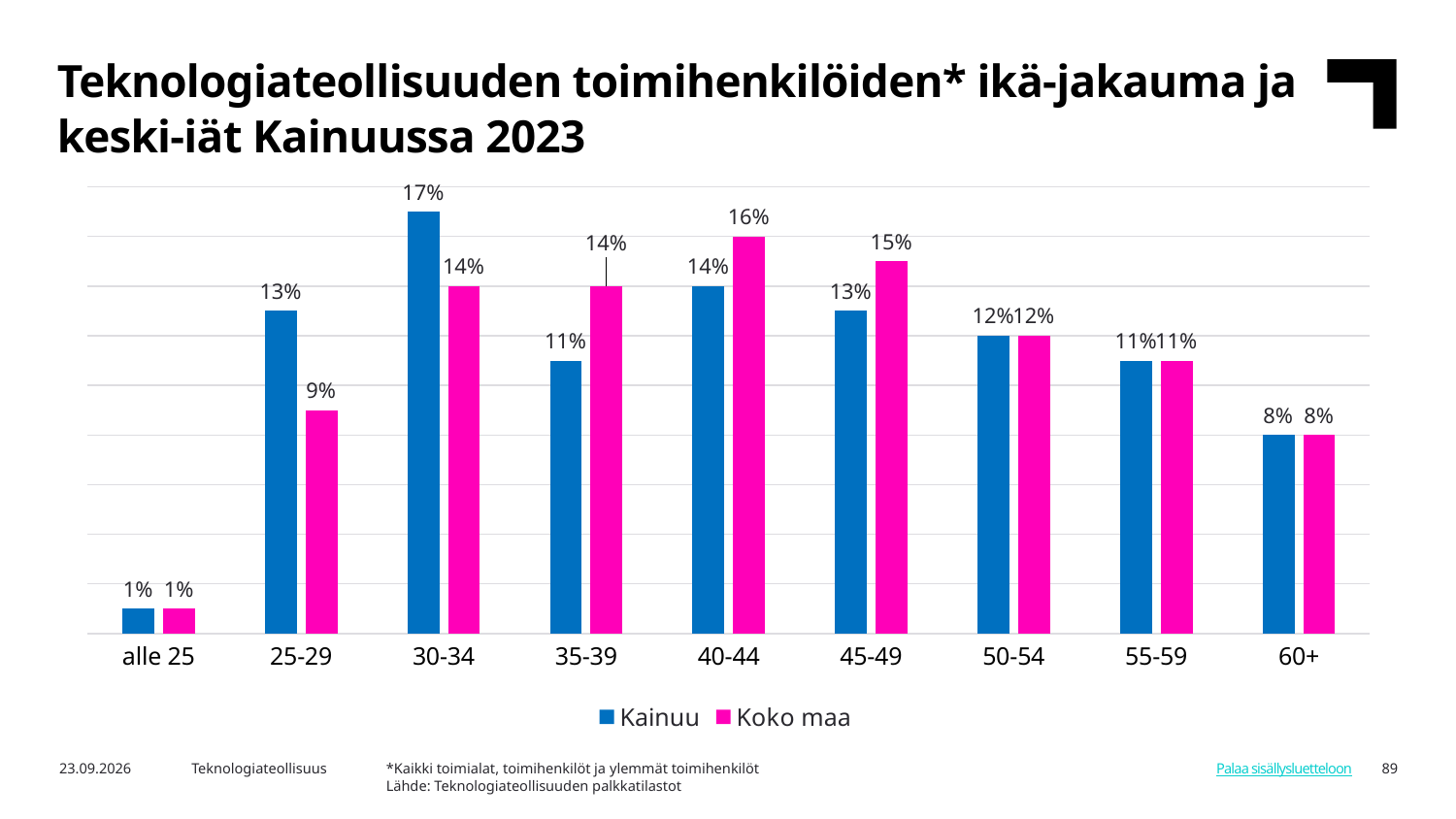
What is the Koko maa value for the 40-44 age group? 16% What is the Koko maa value for the 25-29 age group? 9% How many series does the legend list? 2 What is the Kainuu value for the 30-34 age group? 17% For the 35-39 age group, which is larger: the Kainuu value or the Koko maa value? Koko maa Which age group has the lowest Koko maa value? alle 25 Which series is shown in pink in the legend? Koko maa Do the Kainuu values rise or fall from the 45-49 age group to the 60+ age group? Fall What kind of chart is shown on the slide? Bar chart How many age groups are shown on the x axis? 9 Which age group has the highest Kainuu value? 30-34 What is the difference between the Kainuu and Koko maa values for the 25-29 age group? 4 percentage points